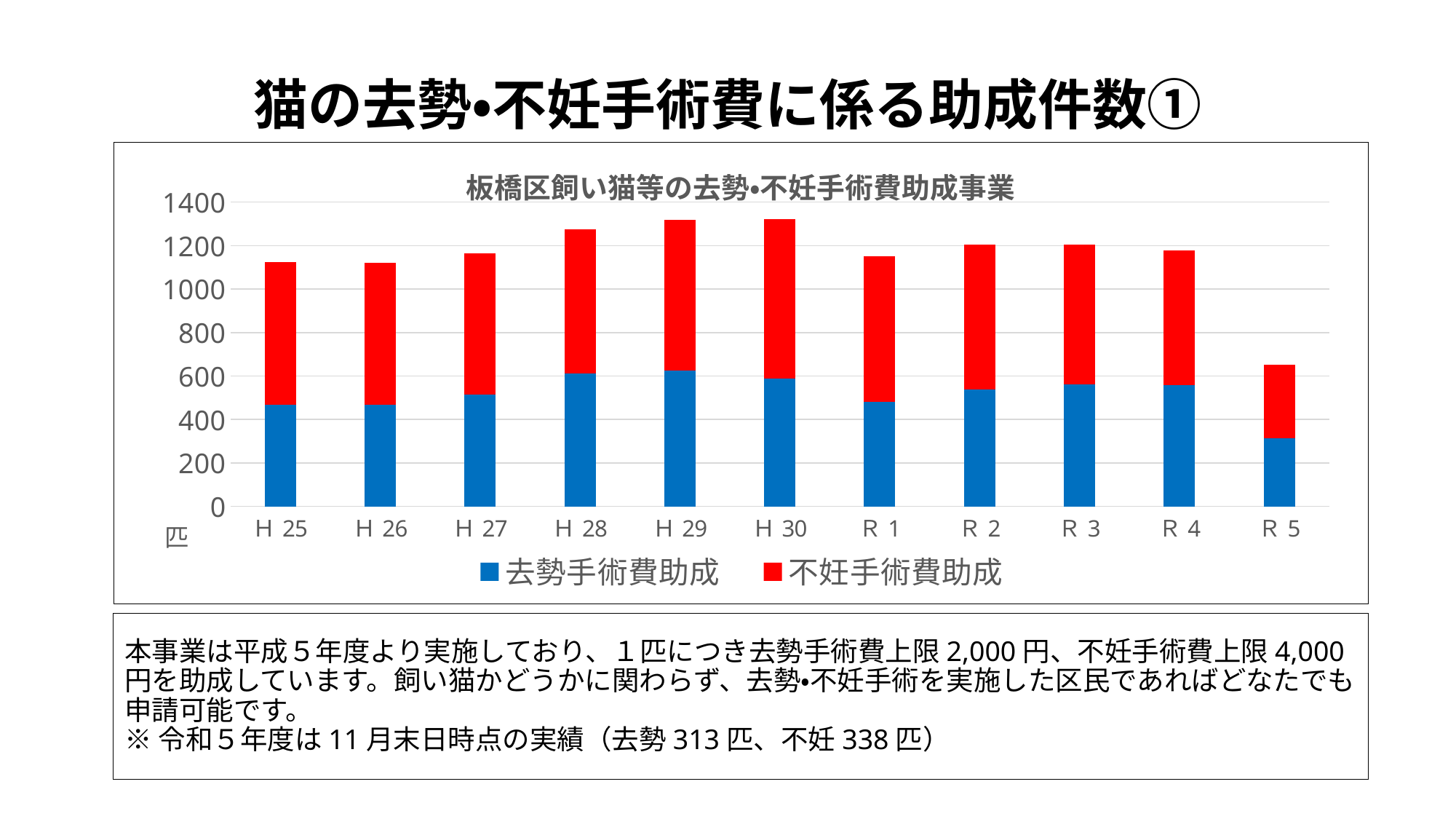
Is the total value for H 25 greater or less than 1000? greater Which colour represents 去勢手術費助成 in the chart? blue How many series does the legend list? 2 What is the total of the R 5 stacked bar (去勢 313 + 不妊 338)? 651 Which has the larger total, H 28 or H 26? H 28 How many fiscal-year categories are shown on the x axis? 11 Is the 去勢手術費助成 value for R 1 greater or less than 600? less According to the note on the slide, how many 不妊 (spaying) subsidies were there in R 5? 338匹 Do the total values rise or fall from H 25 to H 30? rise Which fiscal year has the lowest total number of subsidies? R 5 What kind of chart is shown on the slide? stacked bar chart According to the note on the slide, how many 去勢 (castration) subsidies were there in R 5? 313匹